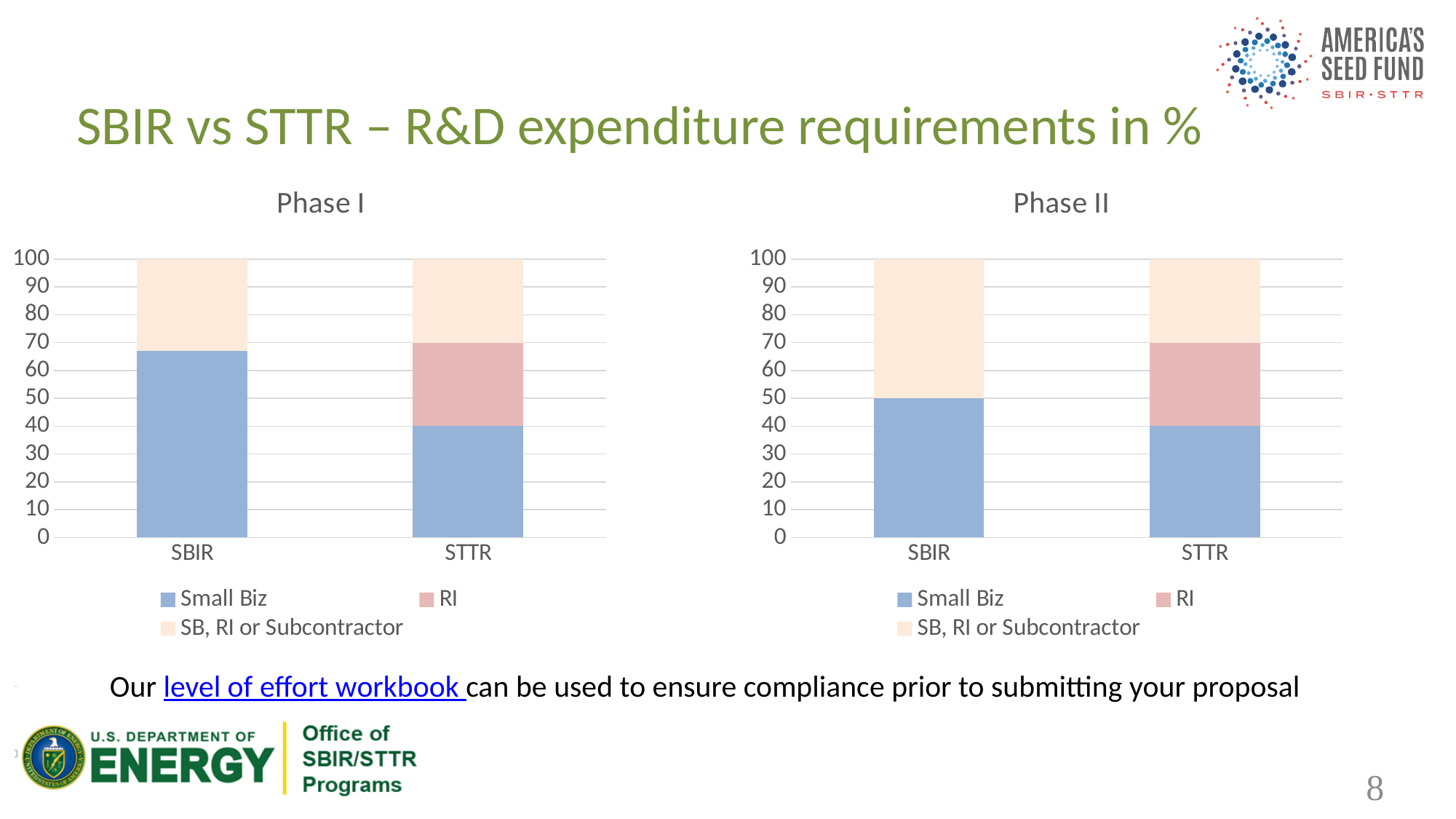
What are the three legend entries of the Phase II chart? Small Biz, RI, SB, RI or Subcontractor In the Phase I chart, is the Small Biz value for SBIR greater or less than 60? greater How many categories are shown on the x axis of the Phase II chart? 2 What kind of chart is the Phase I chart? Stacked bar chart In the Phase I chart, which category has the larger Small Biz value, SBIR or STTR? SBIR How many series does the legend of the Phase I chart list? 3 In the Phase II chart, what is the Small Biz value for STTR? 40 In the Phase II chart, what is the Small Biz value for SBIR? 50 In the Phase II chart, which category has the larger Small Biz value, SBIR or STTR? SBIR In the Phase I chart, is the Small Biz value for SBIR greater or less than 70? less In the Phase II chart, what is the total of the stacked bar for STTR? 100 In the Phase I chart, what is the Small Biz value for STTR? 40